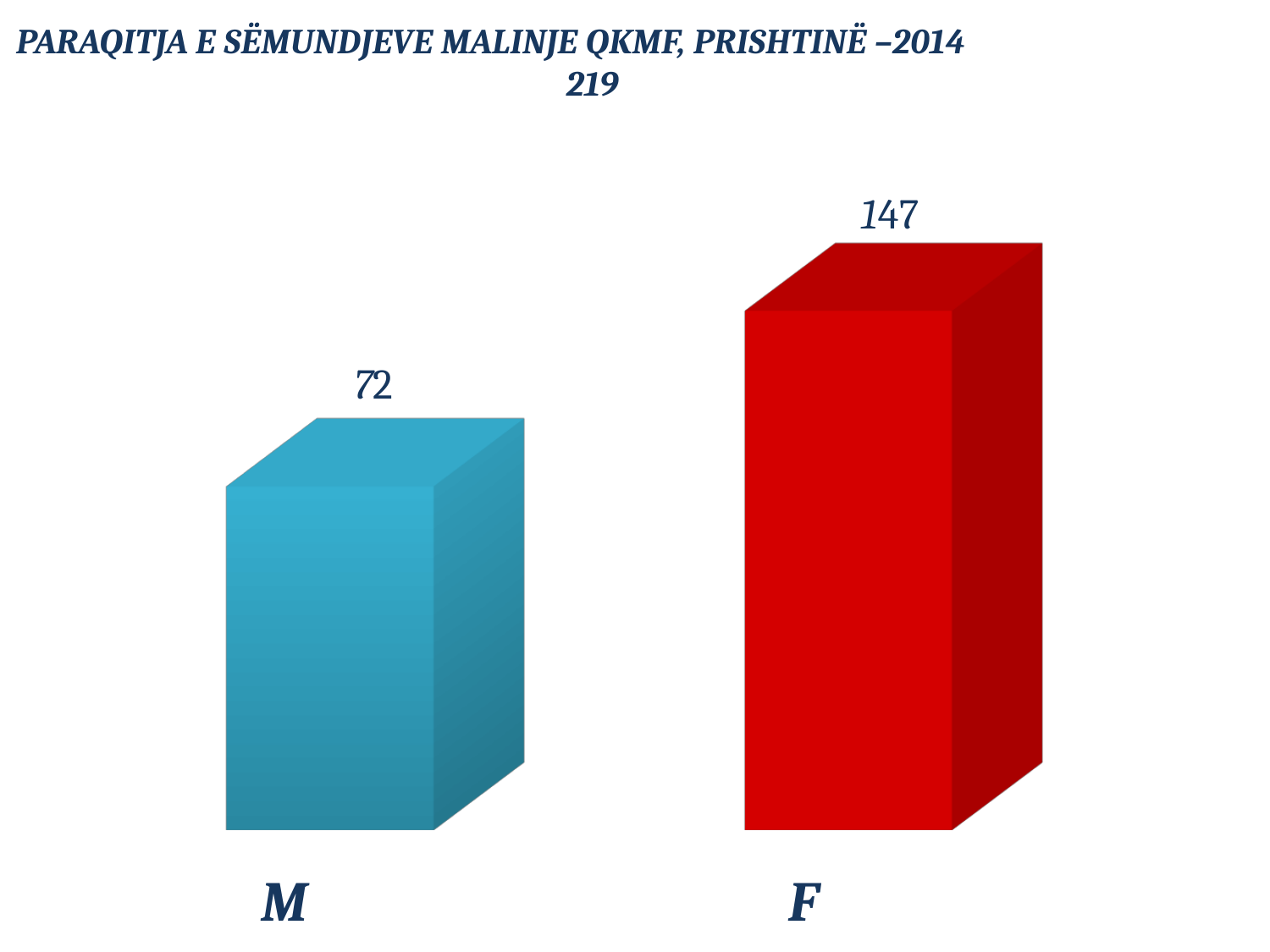
What kind of chart is shown on the slide? Bar chart What colour is the bar for F? Red What colour is the bar for M? Blue What is the total of the values for M and F? 219 What is the difference between the values for F and M? 75 What is the value for M? 72 Which category has the highest value? F How many categories are shown in the chart? 2 What is the value for F? 147 Which category has the lowest value? M Which is larger, the value for M or the value for F? F